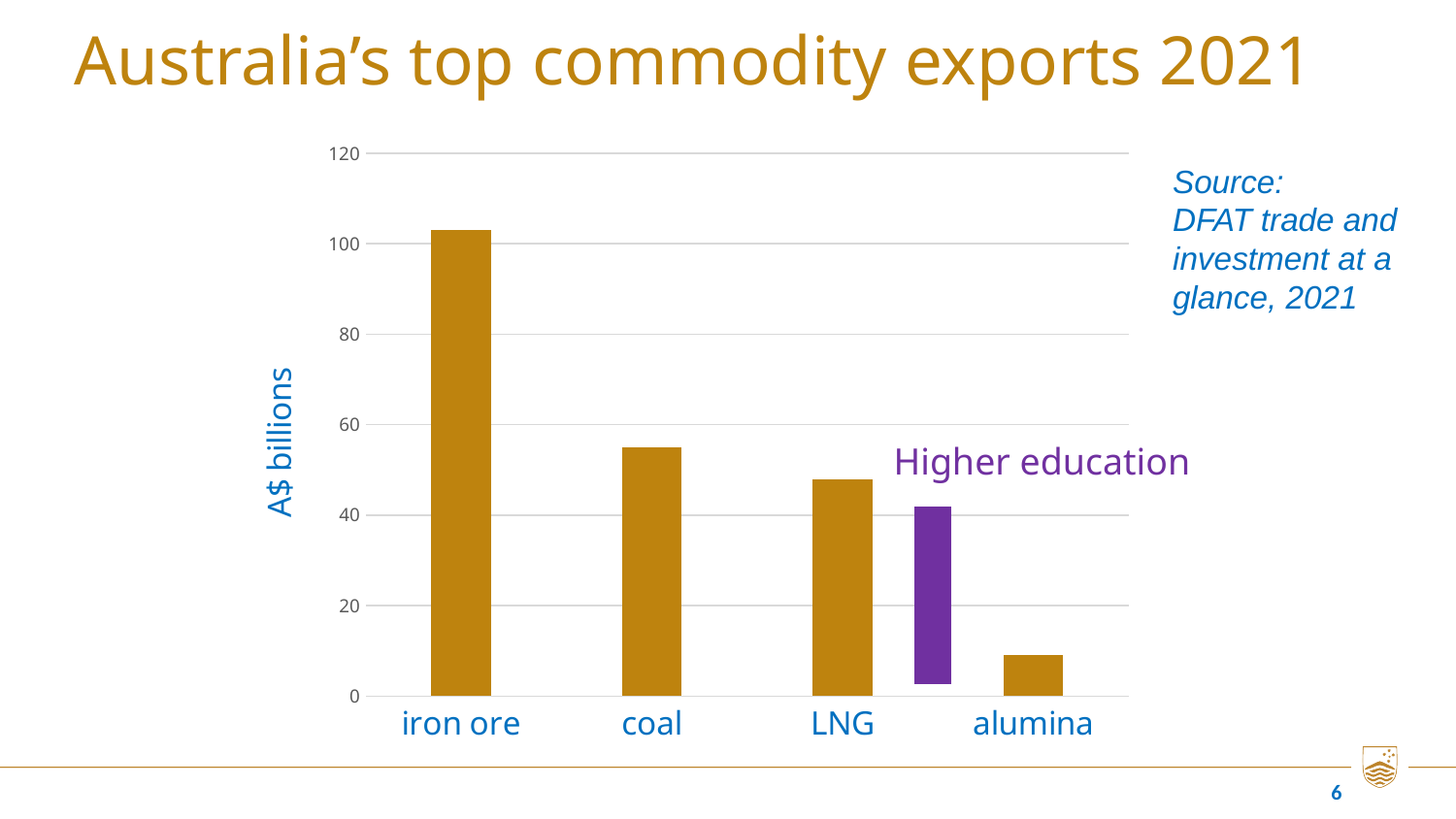
Which commodity has the highest export value in the chart? iron ore Which is larger, the value for coal or the value for LNG? coal What is the label on the vertical axis of the chart? A$ billions Is the value for alumina greater or less than 20? less What kind of chart is shown on the slide? bar chart How many commodity categories are labelled on the x axis? 4 Is the value for Higher education greater or less than 60? less Which commodity has the lowest export value in the chart? alumina Is the value for LNG greater or less than 40? greater Do the commodity export values rise or fall from left to right along the x axis? fall